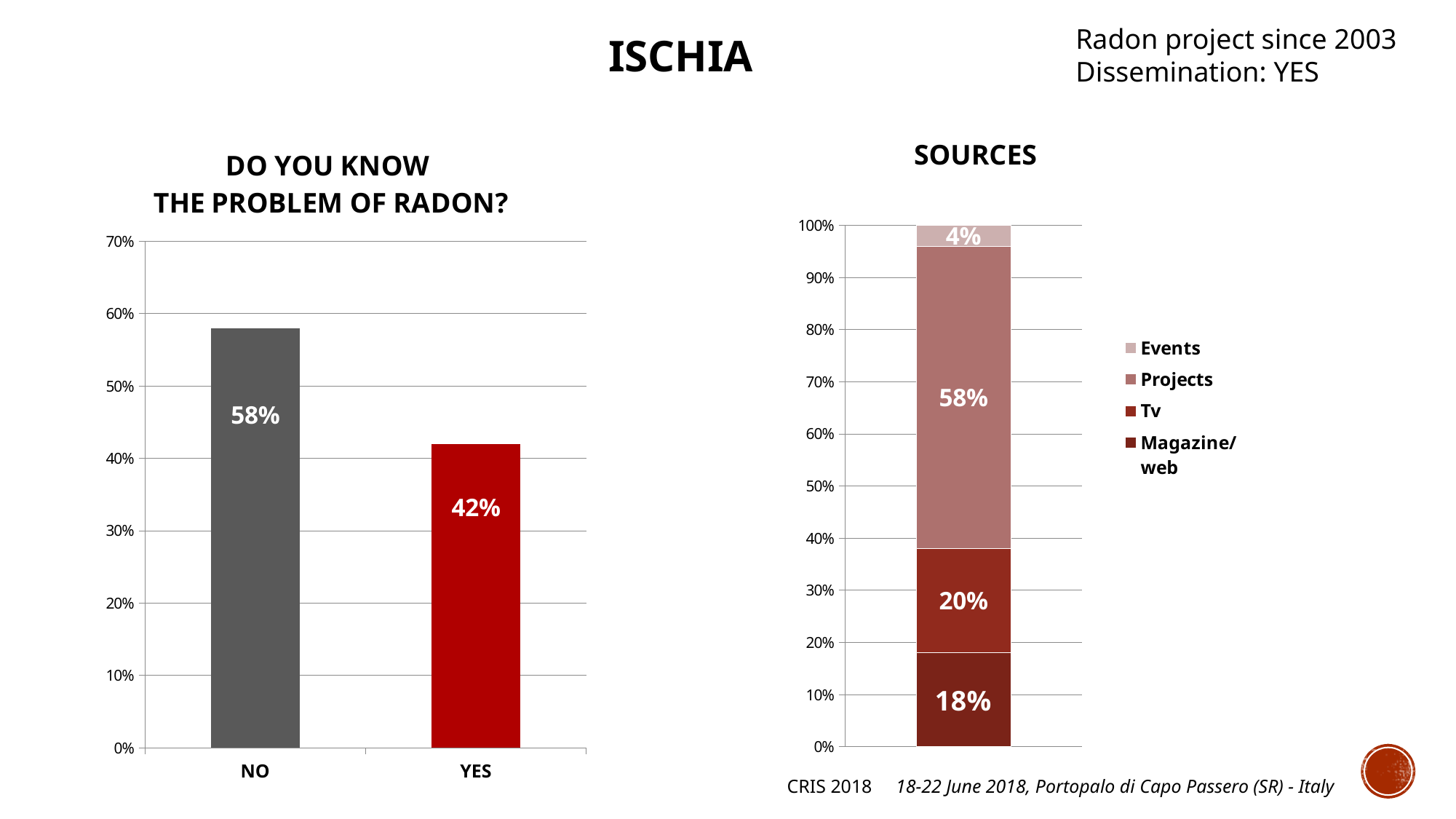
In the SOURCES chart, which source has the smallest share? Events In the 'DO YOU KNOW THE PROBLEM OF RADON?' chart, what is the difference between the NO and YES values? 16% In the 'DO YOU KNOW THE PROBLEM OF RADON?' chart, which category has the higher value? NO In the SOURCES chart, how many series does the legend list? 4 In the 'DO YOU KNOW THE PROBLEM OF RADON?' chart, what is the value for YES? 42% In the SOURCES chart, what is the difference between the Projects and Tv values? 38% In the 'DO YOU KNOW THE PROBLEM OF RADON?' chart, what is the value for NO? 58% In the SOURCES chart, what is the value for Magazine/web? 18% What kind of chart is the 'DO YOU KNOW THE PROBLEM OF RADON?' chart? bar chart In the SOURCES chart, what is the value for Projects? 58% In the SOURCES chart, what is the value for Tv? 20% In the 'DO YOU KNOW THE PROBLEM OF RADON?' chart, how many categories are shown on the x axis? 2